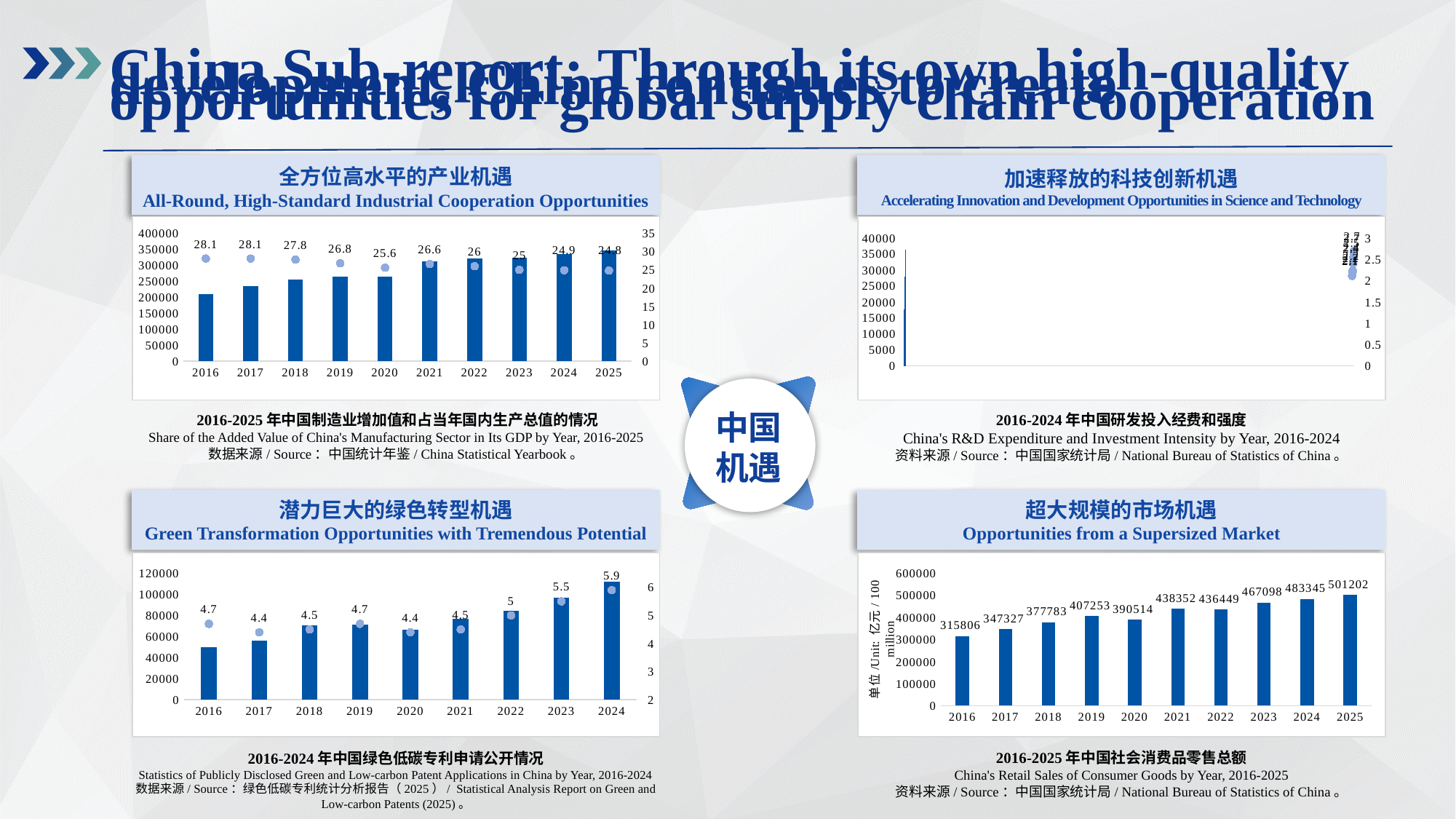
In the 'Opportunities from a Supersized Market' chart, how many years are shown on the x axis? 10 What kind of chart is the 'Opportunities from a Supersized Market' chart? Bar chart In the 'All-Round, High-Standard Industrial Cooperation Opportunities' chart, which year has the lowest labelled share value? 2025 In the 'Opportunities from a Supersized Market' chart, which year has the lowest value? 2016 In the 'Opportunities from a Supersized Market' chart, what is the difference between the 2025 value and the 2016 value? 185396 In the 'All-Round, High-Standard Industrial Cooperation Opportunities' chart, do the labelled share values generally rise or fall from 2016 to 2025? Fall In the 'Opportunities from a Supersized Market' chart, which year has the highest value? 2025 In the 'Green Transformation Opportunities with Tremendous Potential' chart, what is the labelled value for 2024? 5.9 In the 'All-Round, High-Standard Industrial Cooperation Opportunities' chart, what is the labelled share value for 2016? 28.1 In the 'Green Transformation Opportunities with Tremendous Potential' chart, is the bar for 2024 greater or less than 100000? greater In the 'Opportunities from a Supersized Market' chart, what is the value for 2025? 501202 In the 'Opportunities from a Supersized Market' chart, which year has the larger value, 2019 or 2020? 2019